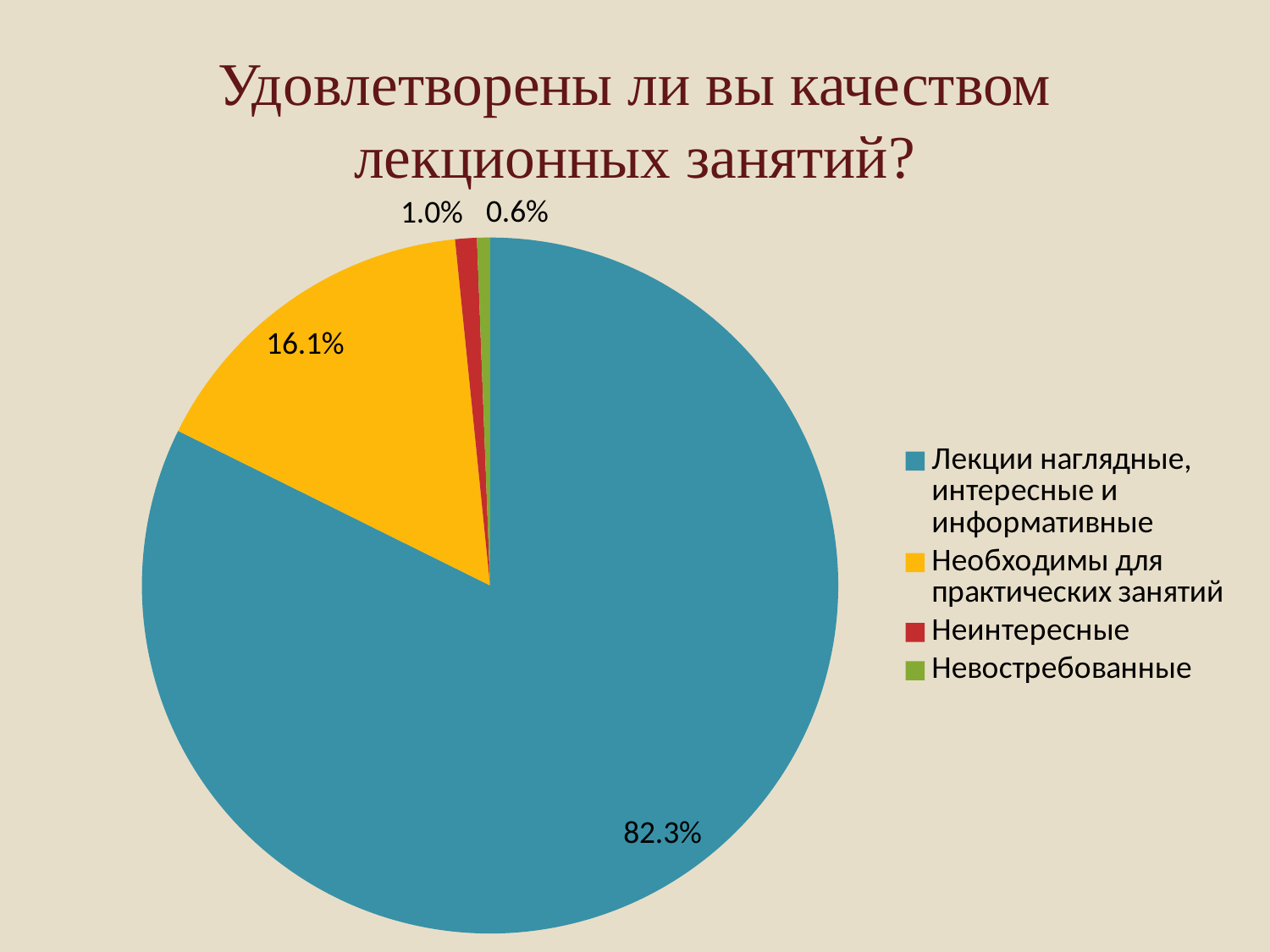
How many categories does the legend list? 4 What share of the pie is labelled "Необходимы для практических занятий"? 16.1% What is the title of the chart? Удовлетворены ли вы качеством лекционных занятий? Which is larger: the share for "Неинтересные" or the share for "Невостребованные"? Неинтересные What share of the pie is labelled "Невостребованные"? 0.6% What share of the pie is labelled "Неинтересные"? 1.0% Which category has the smallest slice of the pie? Невостребованные What colour is the slice for "Необходимы для практических занятий"? yellow What is the difference between the shares for "Лекции наглядные, интересные и информативные" and "Необходимы для практических занятий"? 66.2% What kind of chart is shown on the slide? pie chart Which category has the largest slice of the pie? Лекции наглядные, интересные и информативные